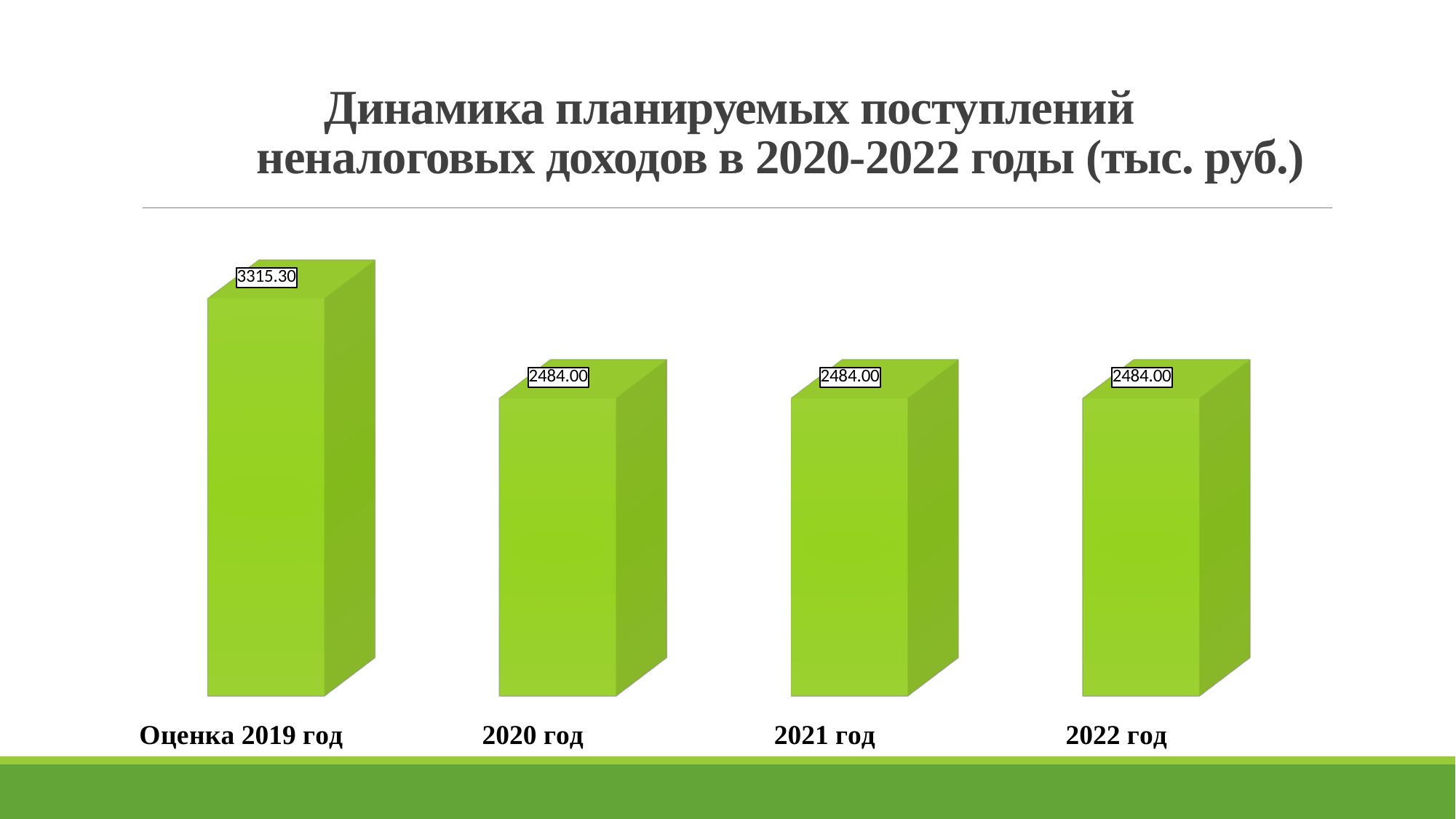
What is the value for 2020 год? 2484.00 What kind of chart is shown on the slide? Bar chart What is the difference between the values for Оценка 2019 год and 2020 год? 831.30 What is the value for Оценка 2019 год? 3315.30 Which is larger, the value for Оценка 2019 год or the value for 2021 год? Оценка 2019 год What colour are the bars on the chart? Green Which category has the highest value? Оценка 2019 год How many categories are shown on the chart? 4 What is the value for 2022 год? 2484.00 Are the values for 2020 год, 2021 год and 2022 год the same or different? The same Do the values rise or fall from Оценка 2019 год to 2020 год? Fall What is the title of the chart? Динамика планируемых поступлений неналоговых доходов в 2020-2022 годы (тыс. руб.)